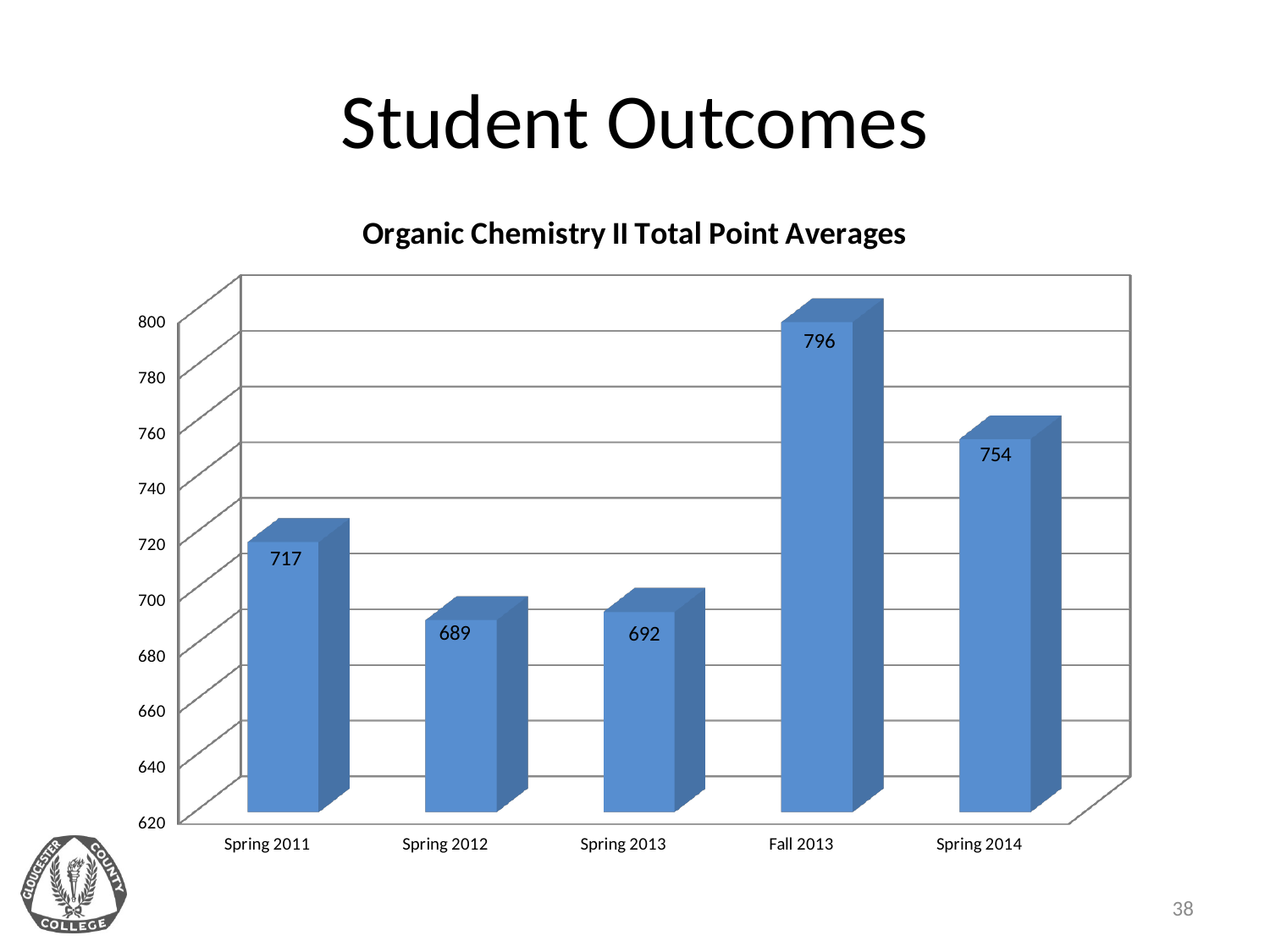
Which is larger, the total point average for Spring 2011 or Spring 2013? Spring 2011 What is the total point average for Spring 2014? 754 What is the title of the chart? Organic Chemistry II Total Point Averages What kind of chart is shown on the slide? bar chart What is the total point average for Fall 2013? 796 What is the difference between the Fall 2013 and Spring 2014 total point averages? 42 Which semester has the highest total point average? Fall 2013 Is the value for Spring 2013 greater or less than 700? less Which semester has the lowest total point average? Spring 2012 What is the total point average for Spring 2011? 717 How many semesters are shown on the chart? 5 What is the difference between the Spring 2011 and Spring 2012 total point averages? 28